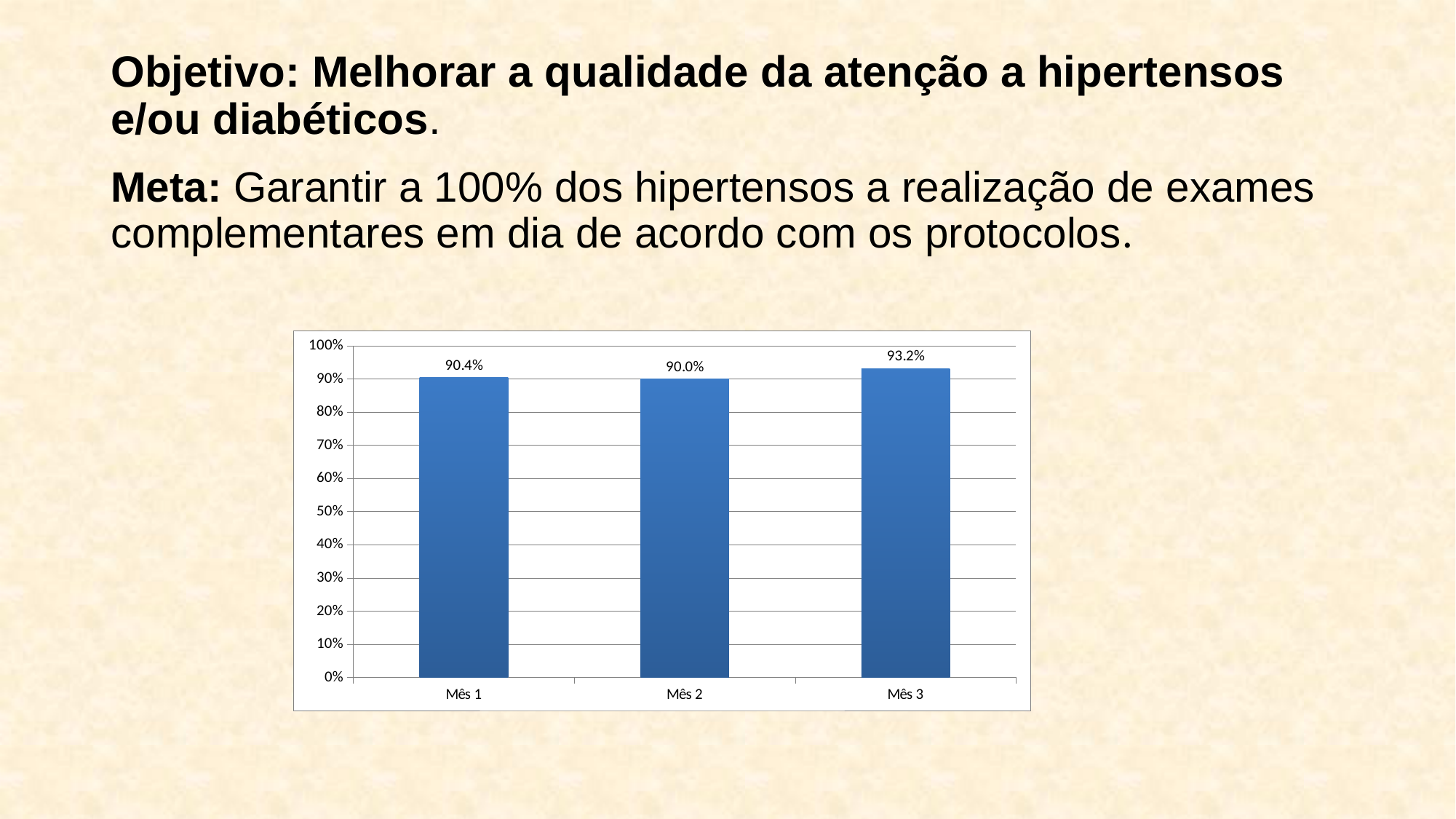
How many months are shown on the x axis? 3 Is the value for Mês 3 greater or less than 90%? greater What is the highest value shown on the y axis? 100% What kind of chart is shown on the slide? bar chart Which month has the highest value? Mês 3 What is the value for Mês 3? 93.2% What is the value for Mês 2? 90.0% Which is larger, the value for Mês 3 or the value for Mês 2? Mês 3 What is the difference between the values for Mês 3 and Mês 1? 2.8% What is the difference between the values for Mês 1 and Mês 2? 0.4% Which month has the lowest value? Mês 2 What is the value for Mês 1? 90.4%